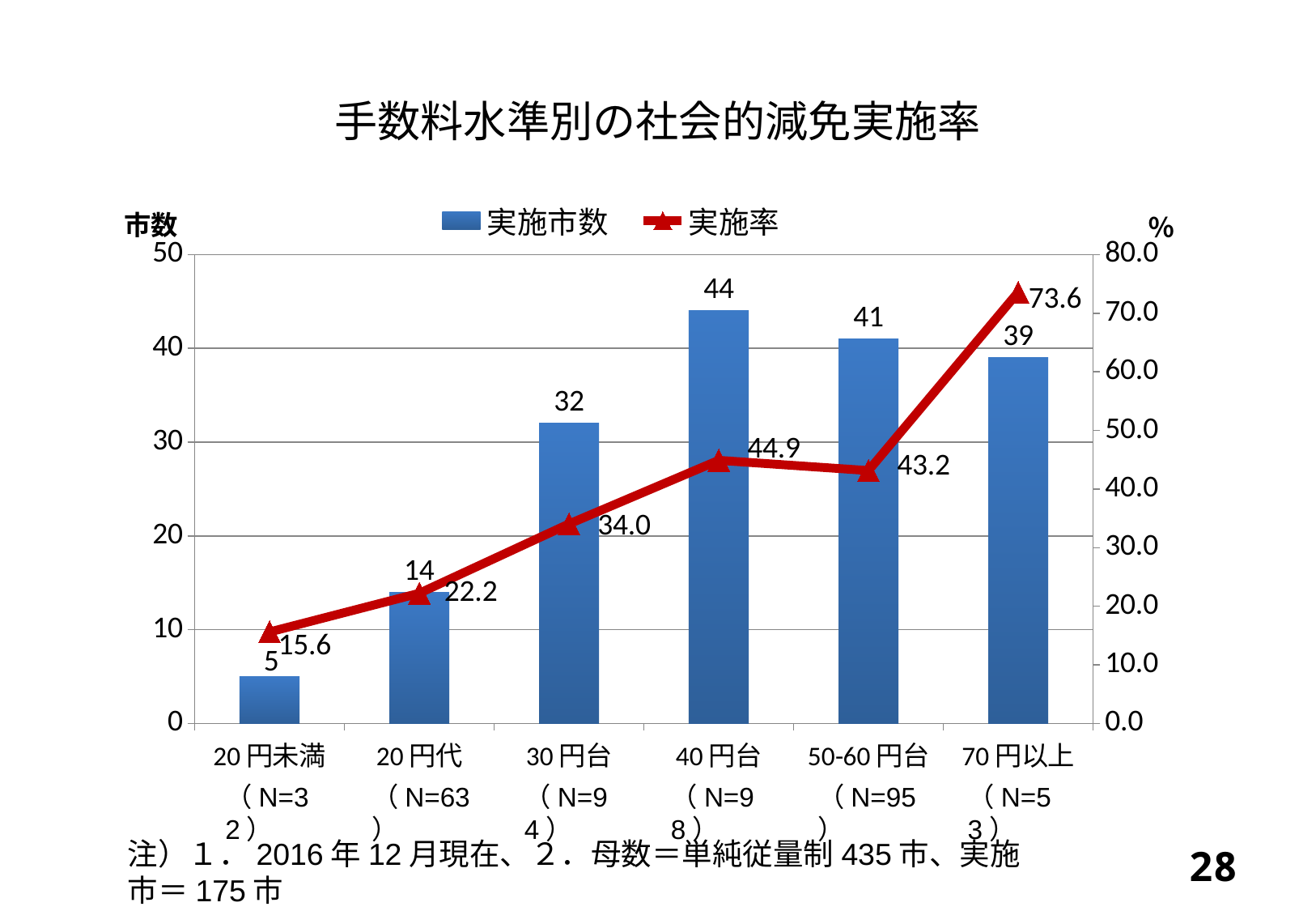
Which category has the lowest 実施率? 20円未満 What is the difference in 実施率 between the 70円以上 and 50-60円台 categories? 30.4 What is the title of the chart? 手数料水準別の社会的減免実施率 What is the 実施率 value for the 20円未満 category? 15.6 What is the difference in 実施市数 between the 40円台 and 50-60円台 categories? 3 What is the 実施市数 value for the 40円台 category? 44 What is the 実施率 value for the 70円以上 category? 73.6 How many series does the legend list? 2 Which is larger, the 実施市数 for 30円台 or for 70円以上? 70円以上 What kind of chart is this? Combined bar and line chart How many categories are shown on the x axis? 6 Which category has the highest 実施市数 bar? 40円台